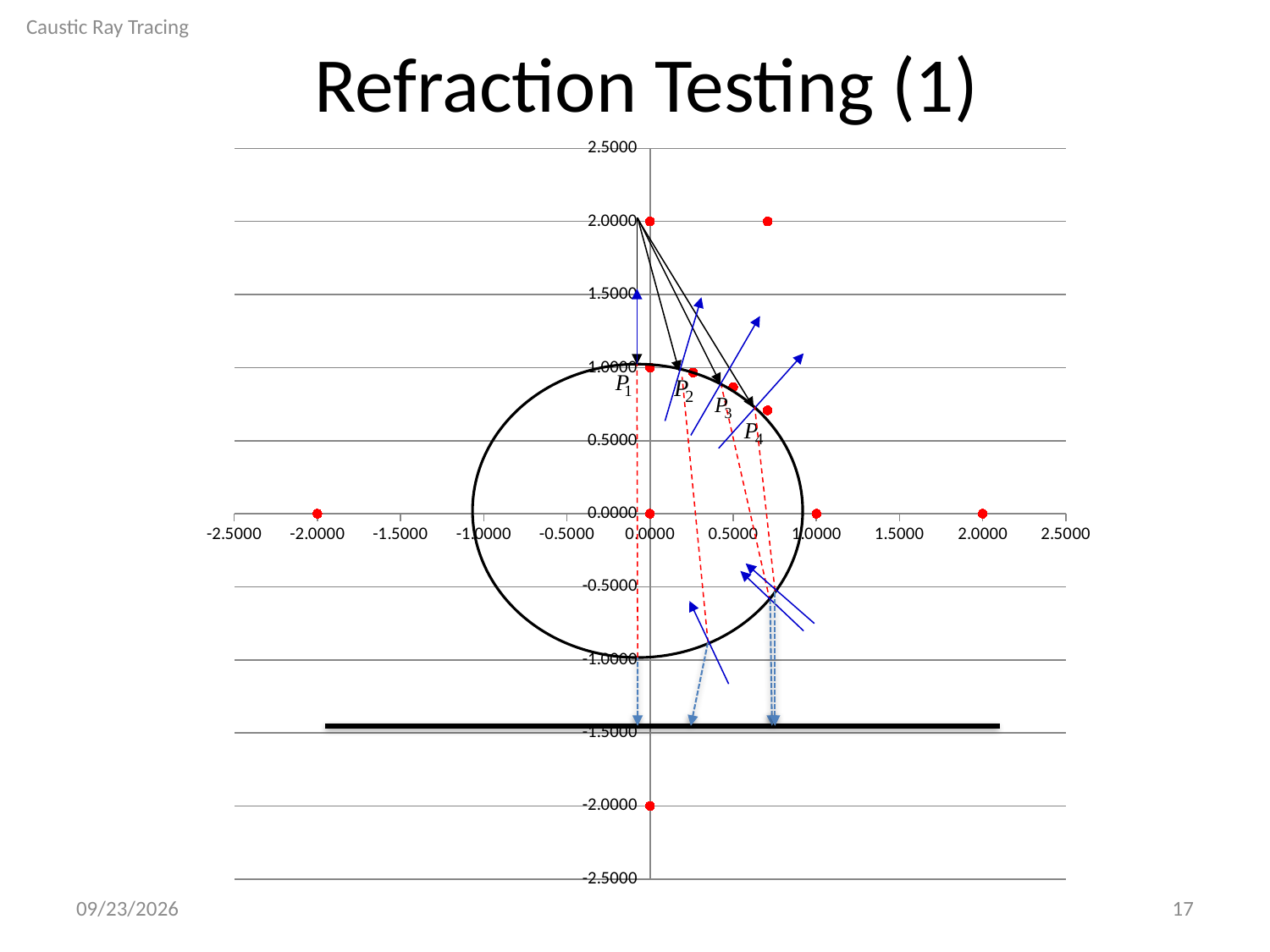
What is the y value of the red point lowest on the y axis? -2.0000 Is the y value of point P4 greater or less than 0.5000? greater How many points on the chart are labeled with a P subscript (P1, P2, ...)? 4 What is the y value of the red point highest on the y axis? 2.0000 What is the title of the slide containing the chart? Refraction Testing (1) Is the x value of point P4 greater or less than 1.0000? less What kind of chart is shown on the slide? scatter chart What is the x value of the red point farthest to the right on the x axis? 2.0000 What is the maximum value shown on the x axis? 2.5000 What is the minimum value shown on the y axis? -2.5000 What is the x value of the red point farthest to the left on the x axis? -2.0000 Which of the labeled points P1 to P4 has the largest x value? P4